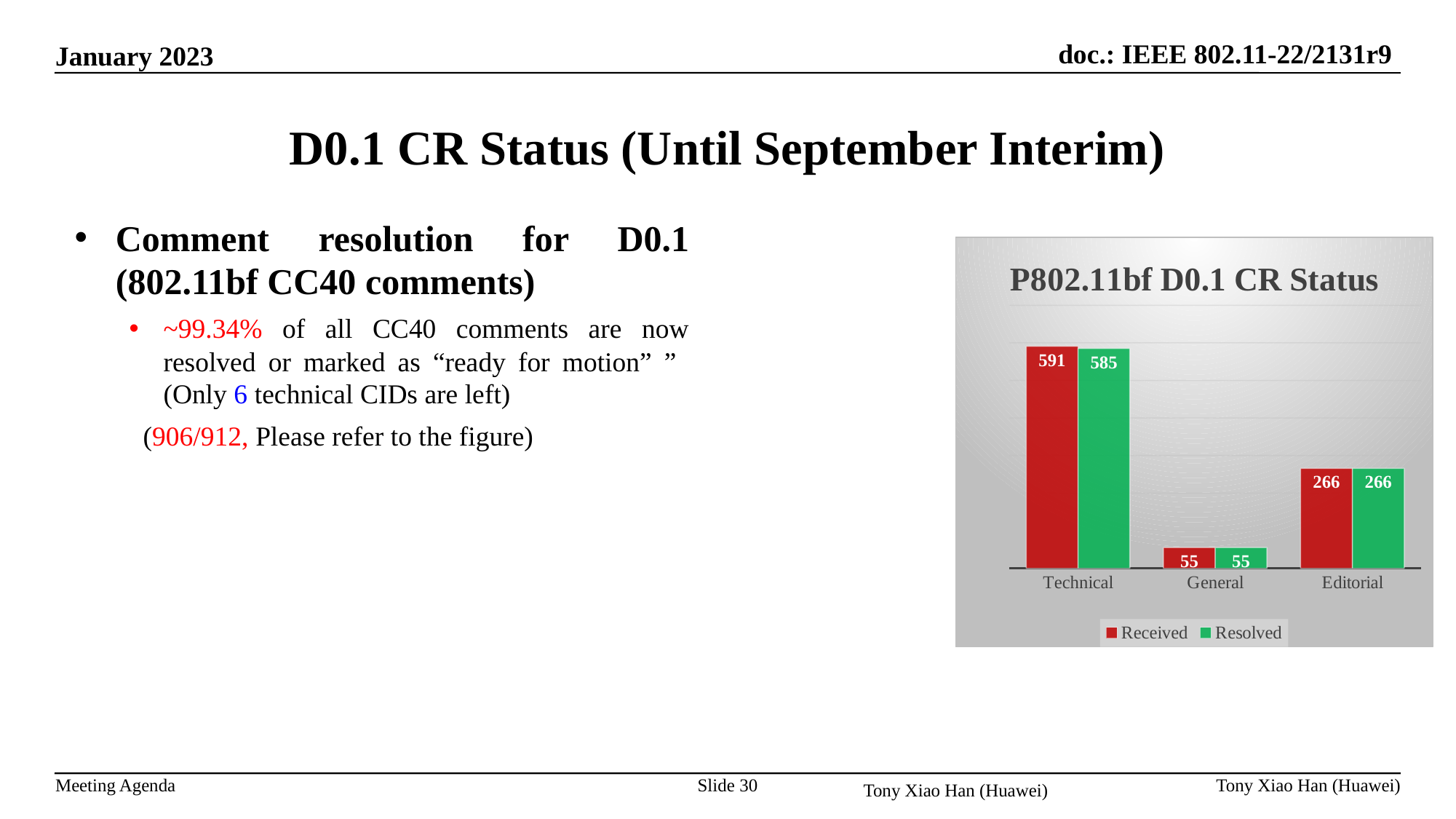
What is the Resolved value for Editorial? 266 What kind of chart is shown? Bar chart What is the difference between the Received values for Technical and Editorial? 325 What is the Received value for General? 55 What is the Resolved value for Technical? 585 Which is larger, the Received value for Editorial or the Received value for General? Editorial Which category has the highest Received value? Technical How many categories are shown on the x axis? 3 What is the Received value for Technical? 591 How many series does the legend list? 2 What is the difference between Received and Resolved for Technical? 6 Which category has the lowest Resolved value? General